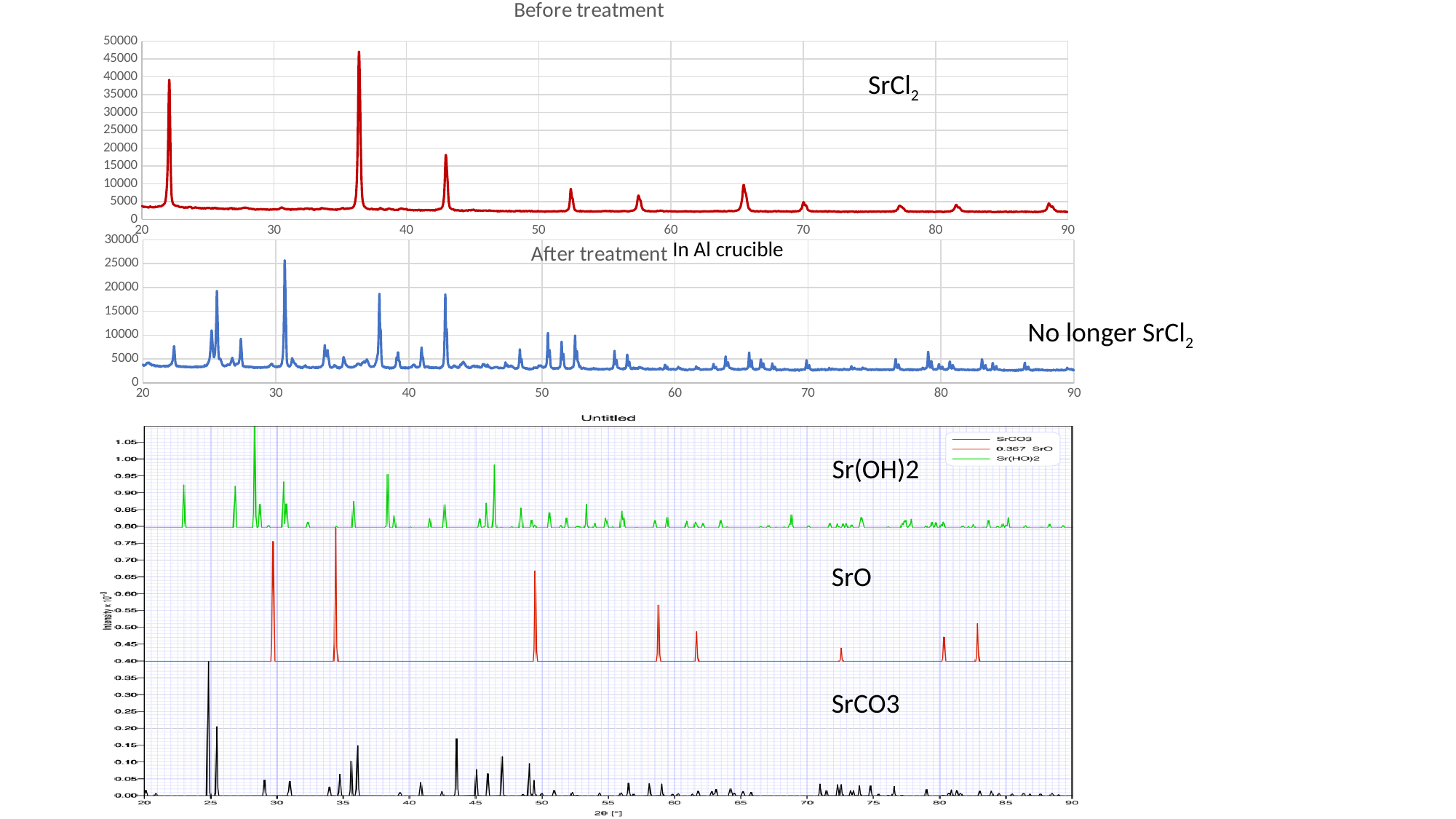
In the "Before treatment" chart, is the peak near 22 on the x axis greater or less than 35000? greater What is the maximum value shown on the y axis of the "Before treatment" chart? 50000 What range does the x axis cover in the "Before treatment" chart? 20 to 90 What colour is the line in the "After treatment" chart? Blue What are the legend entries in the bottom "Untitled" chart? SrCO3, 0.367 SrO, Sr(HO)2 How many series does the legend of the bottom "Untitled" chart list? 3 In the "Before treatment" chart, is the tallest peak (near 36 on the x axis) greater or less than 40000? greater In the "Before treatment" chart, which peak is higher: the one near 22 or the one near 36 on the x axis? The one near 36 What kind of chart is the "Before treatment" chart at the top of the slide? Line chart What is the maximum value shown on the y axis of the "After treatment" chart? 30000 In the "After treatment" chart, is the tallest peak (near 31 on the x axis) greater or less than 20000? greater